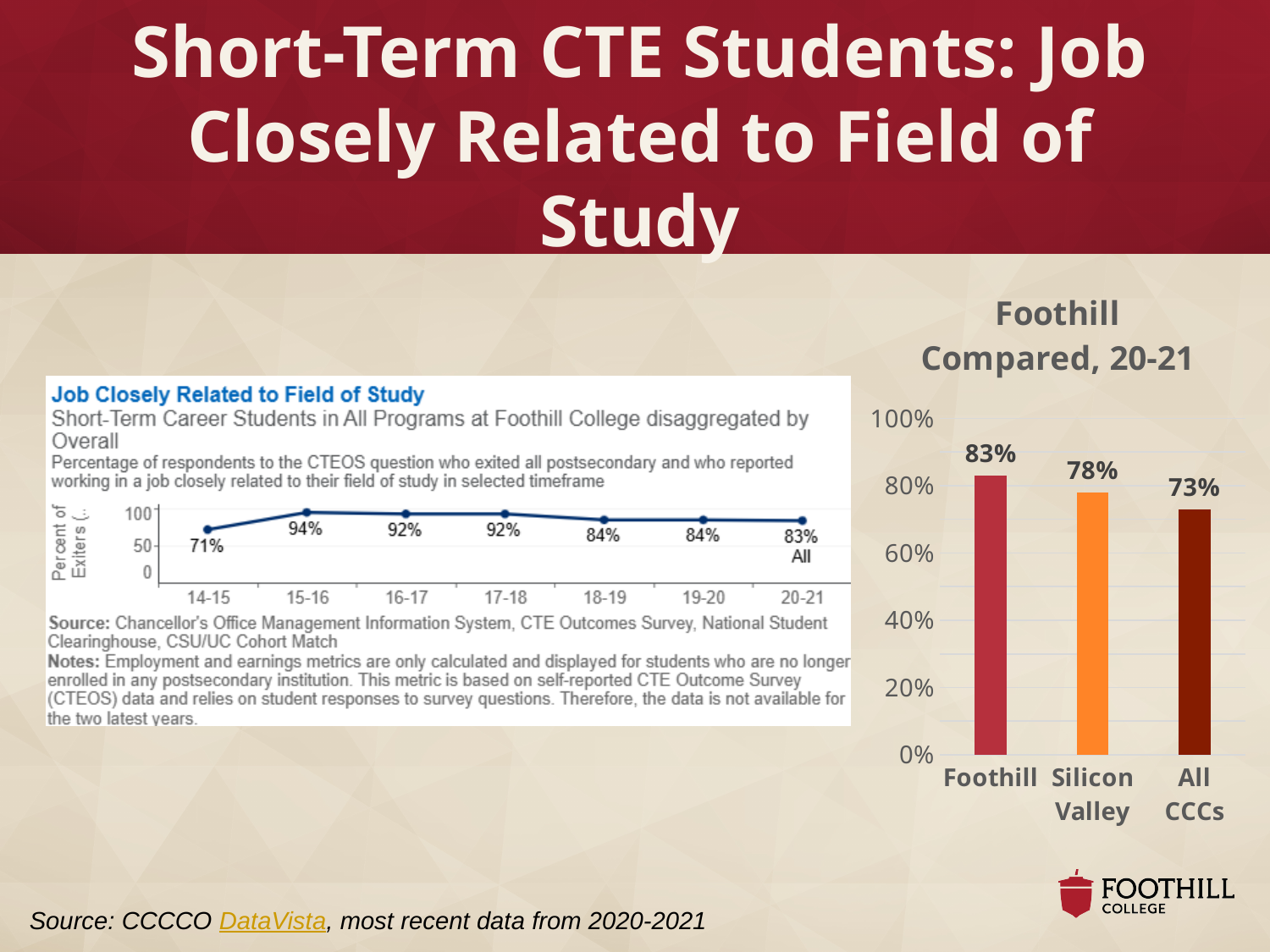
In the 'Job Closely Related to Field of Study' line chart, what is the value for 17-18? 92% In the 'Job Closely Related to Field of Study' line chart, which year has the highest value? 15-16 In the 'Foothill Compared, 20-21' bar chart, what is the difference between Foothill and All CCCs? 10% In the 'Foothill Compared, 20-21' bar chart, what is the value for Foothill? 83% In the 'Job Closely Related to Field of Study' line chart, what is the value for 14-15? 71% In the 'Job Closely Related to Field of Study' line chart, how many data points are plotted? 7 In the 'Foothill Compared, 20-21' bar chart, how many categories are shown? 3 In the 'Foothill Compared, 20-21' bar chart, which category has the lowest value? All CCCs What kind of chart is the 'Foothill Compared, 20-21' chart? Bar chart What kind of chart is the 'Job Closely Related to Field of Study' chart? Line chart In the 'Foothill Compared, 20-21' bar chart, what is the value for Silicon Valley? 78% In the 'Job Closely Related to Field of Study' line chart, what is the difference between the 15-16 and 20-21 values? 11%